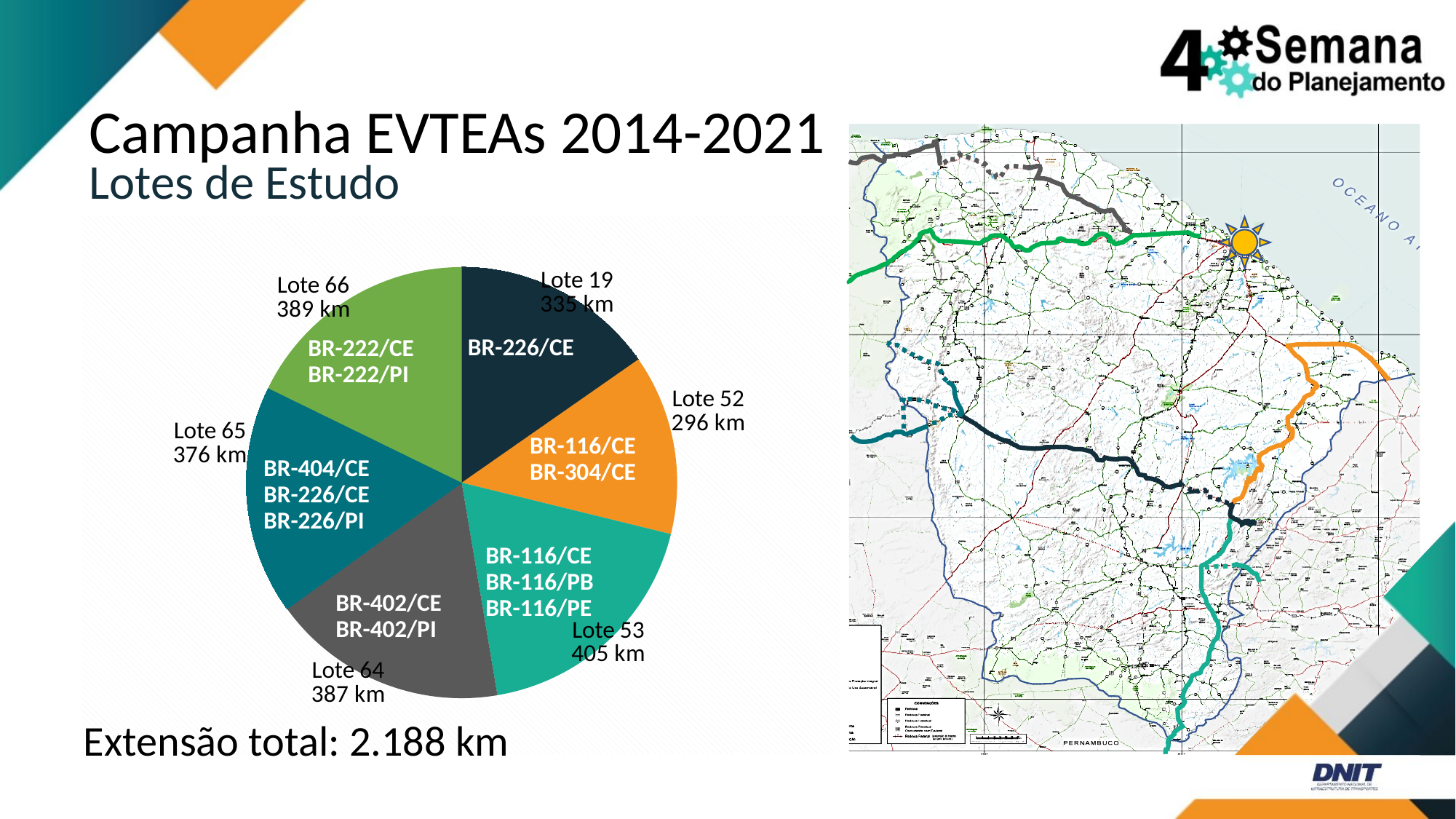
What is the extension shown for Lote 19? 335 km What is the extension shown for Lote 65? 376 km Which lote has the largest extension in the pie chart? Lote 53 What colour is the Lote 52 slice (BR-116/CE, BR-304/CE) in the pie chart? orange What is the extension shown for Lote 52? 296 km What is the total extension (Extensão total) stated on the slide? 2.188 km What kind of chart is shown on the slide? pie chart What is the difference in extension between Lote 53 and Lote 52? 109 km How many lotes (slices) does the pie chart show? 6 Which road is listed in the Lote 19 slice of the pie chart? BR-226/CE Which has a larger extension, Lote 19 or Lote 65? Lote 65 Which lote has the smallest extension in the pie chart? Lote 52